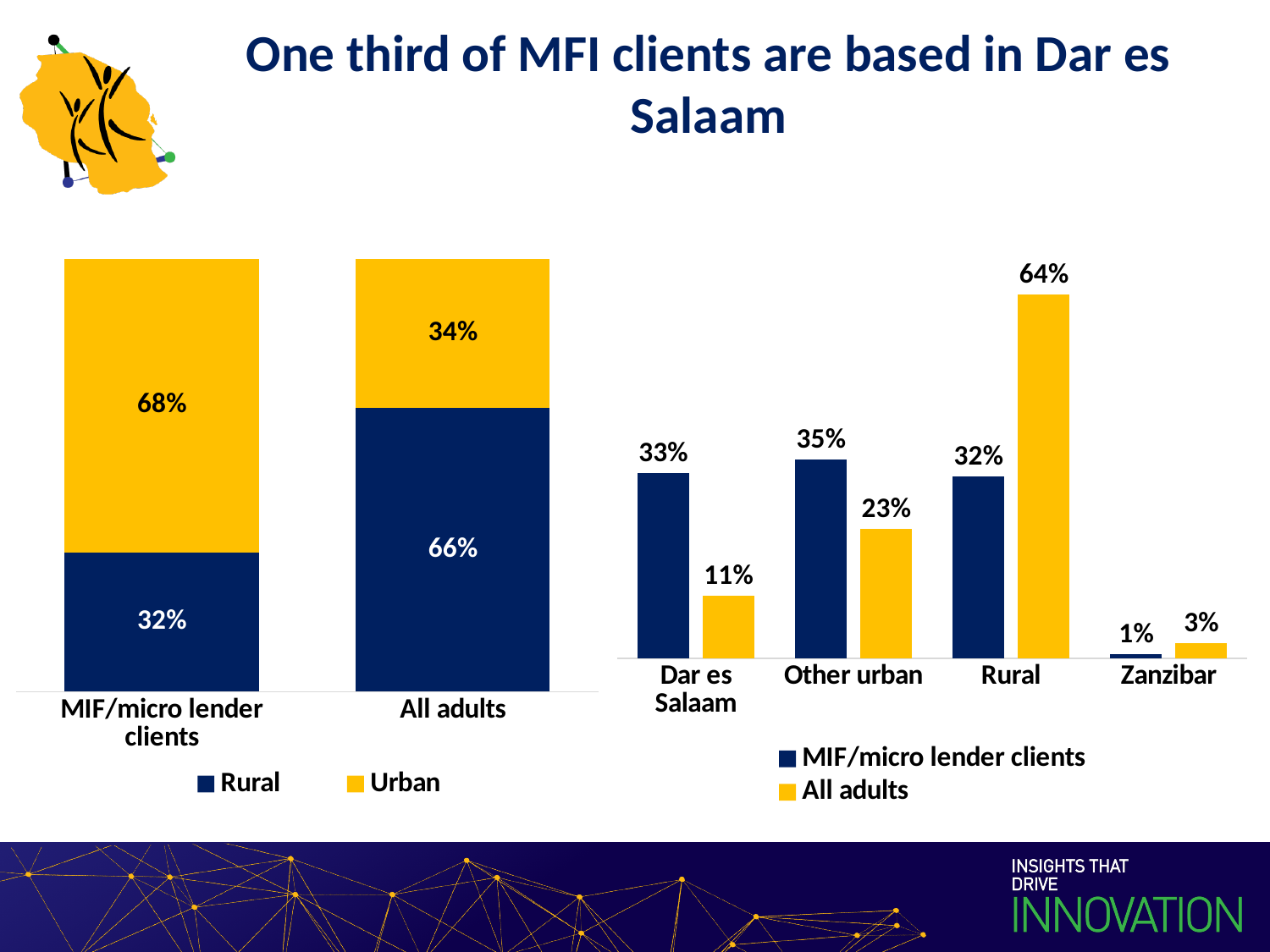
In the right chart, which category has the highest value for MIF/micro lender clients? Other urban In the right chart, what is the difference between MIF/micro lender clients and All adults in Dar es Salaam? 22% In the left chart, what is the Urban share for MIF/micro lender clients? 68% In the left chart, what is the Rural share for All adults? 66% In the left chart, how many series does the legend list? 2 In the right chart, which category has the lowest value for All adults? Zanzibar In the right chart, what is the value for All adults in Rural? 64% In the right chart, what is the value for MIF/micro lender clients in Dar es Salaam? 33% In the left chart, what is the total of the stacked bar for All adults? 100% In the right chart, how many categories are shown on the x axis? 4 In the left chart, what kind of chart is shown? Stacked bar chart In the right chart, which is larger in Rural: MIF/micro lender clients or All adults? All adults